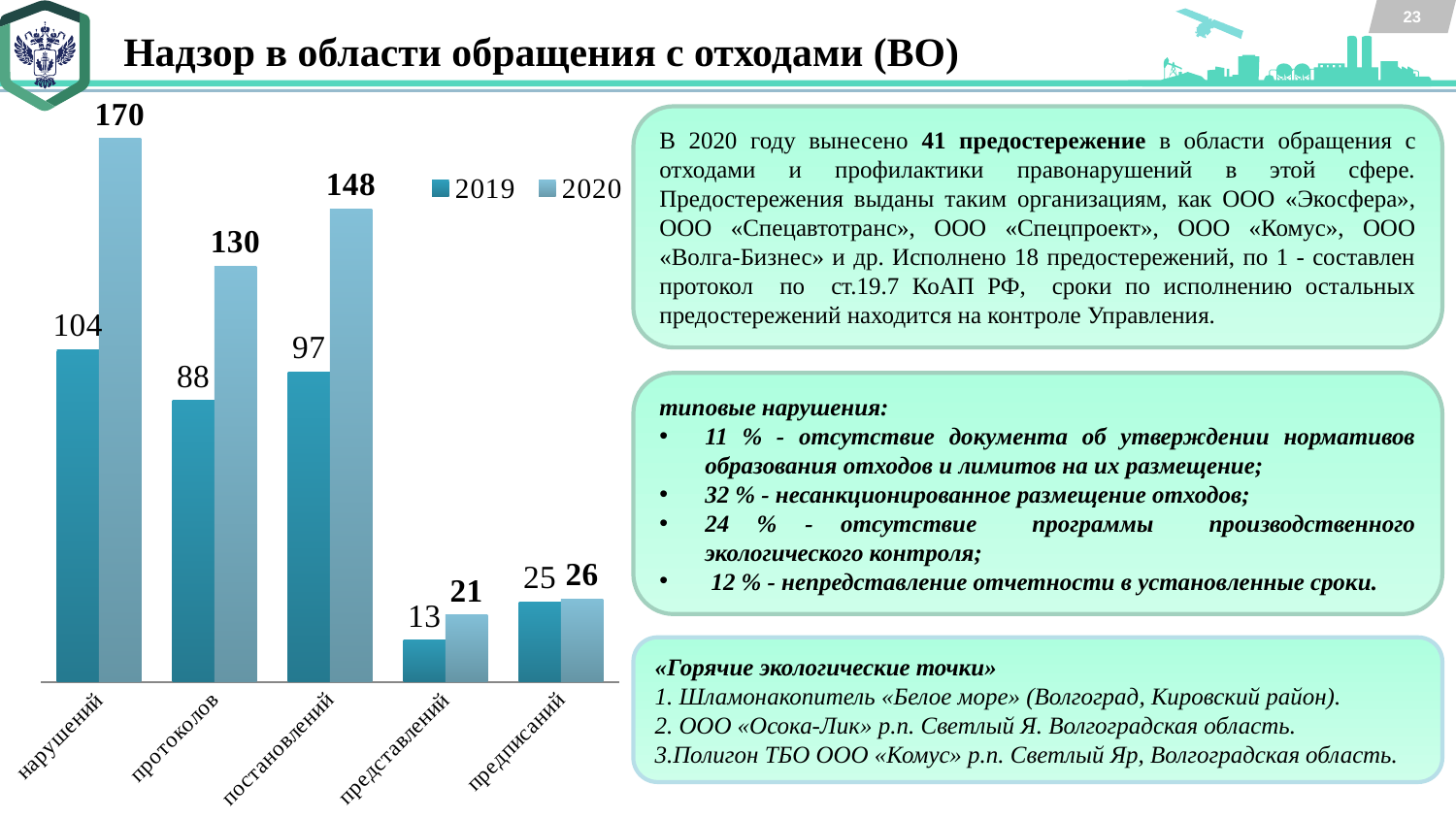
Which series is shown in the darker teal colour in the chart? 2019 Which category has the highest value in the 2019 series? нарушений What is the value for протоколов in 2019? 88 How many categories are shown on the x axis of the chart? 5 What is the value for нарушений in 2020? 170 What is the difference between the 2020 values for нарушений and протоколов? 40 What is the difference between the 2020 and 2019 values for постановлений? 51 Which category has the lowest value in the 2020 series? представлений Which is larger: the 2019 value for постановлений or the 2019 value for протоколов? постановлений What is the value for представлений in 2020? 21 What kind of chart is shown on the slide? bar chart How many series does the chart legend list? 2